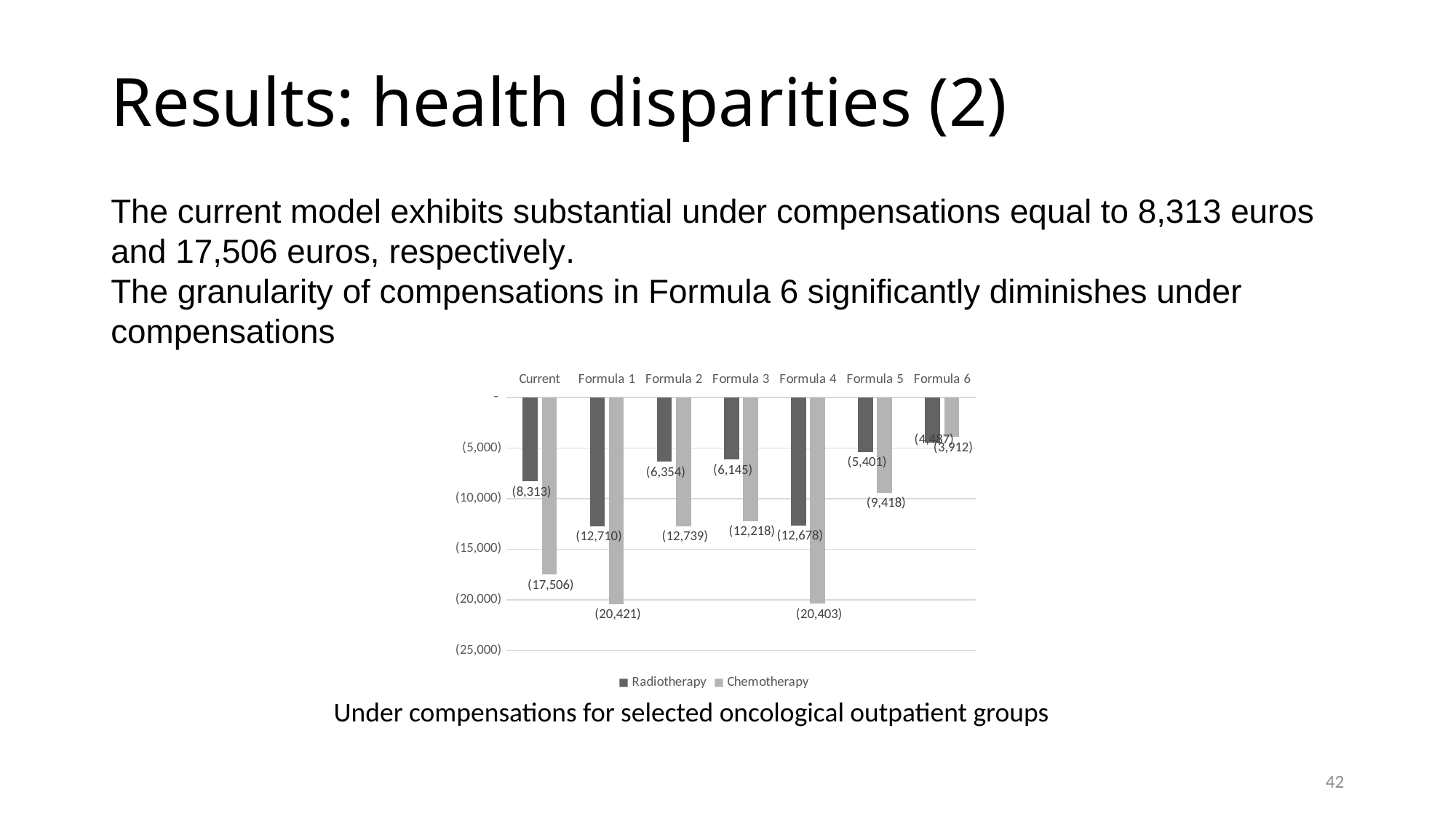
What kind of chart is shown on the slide? Bar chart What is the Chemotherapy value for Formula 6? (3,912) Which is larger in magnitude: the Radiotherapy under compensation for Formula 1 or for Formula 5? Formula 1 How many categories are shown on the x axis? 7 How many series does the legend list? 2 What is the difference between the Chemotherapy and Radiotherapy values for Current? 9,193 Which category has the smallest Chemotherapy under compensation? Formula 6 What is the Radiotherapy value for Current? (8,313) What is the Radiotherapy value for Formula 3? (6,145) What is the Chemotherapy value for Formula 5? (9,418) What are the two series named in the legend? Radiotherapy and Chemotherapy What is the Chemotherapy value for Formula 1? (20,421)